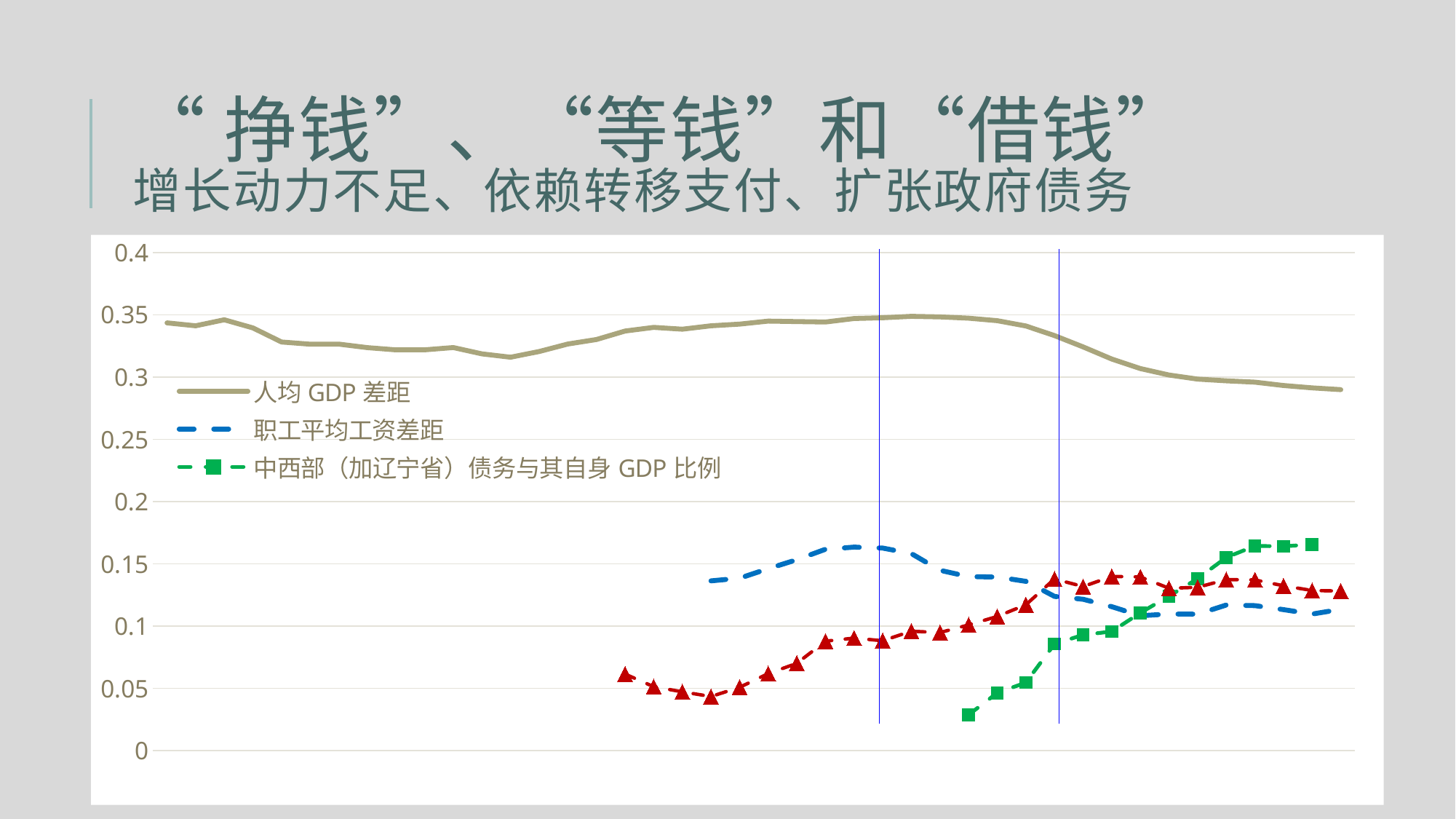
How many series does the chart's legend list? 3 Is the highest value of 职工平均工资差距 greater or less than 0.2? less Does the 人均 GDP 差距 series rise or fall from the second vertical line to the right end of the chart? fall What kind of chart is shown on the slide? line chart Which series is drawn as a blue dashed line? 职工平均工资差距 Is the value for 人均 GDP 差距 at the right end of the chart greater or less than 0.25? greater Which series is drawn with green square markers? 中西部（加辽宁省）债务与其自身 GDP 比例 Is the value for 中西部（加辽宁省）债务与其自身 GDP 比例 at the right end of the chart greater or less than 0.15? greater Does the 中西部（加辽宁省）债务与其自身 GDP 比例 series rise or fall along the x axis? rise Which series reaches the highest values on the chart? 人均 GDP 差距 At the right end of the chart, which is larger: 人均 GDP 差距 or 职工平均工资差距? 人均 GDP 差距